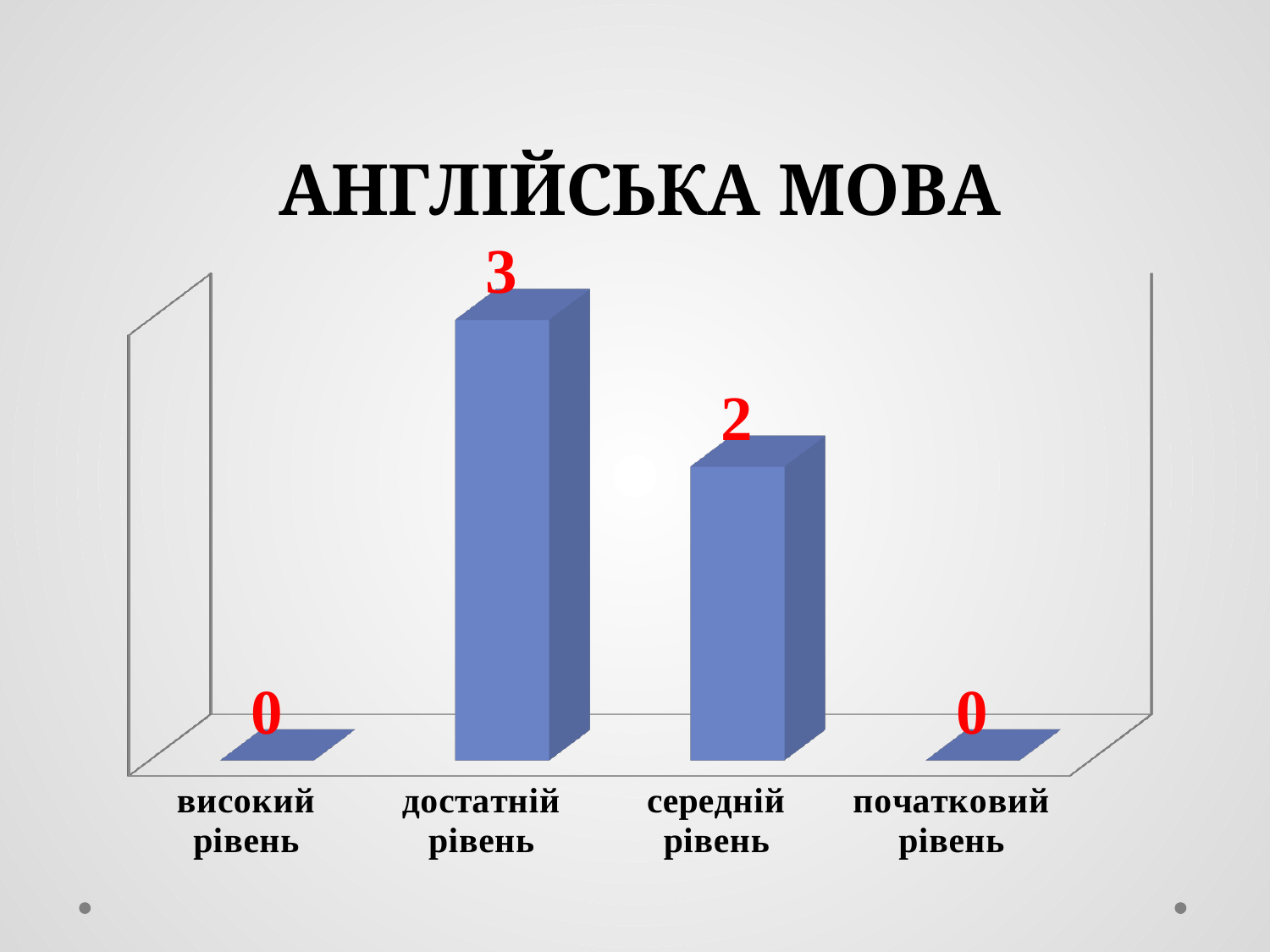
What is the difference between the values for достатній рівень and середній рівень? 1 Which category has the highest value? достатній рівень What kind of chart is shown on the slide? bar chart What is the total of all the values shown in the chart? 5 Which is larger, the value for достатній рівень or the value for середній рівень? достатній рівень What is the title of the chart? АНГЛІЙСЬКА МОВА How many categories have a value of 0? 2 What is the value for достатній рівень? 3 What is the value for середній рівень? 2 What is the value for високий рівень? 0 How many categories are shown on the x axis? 4 What is the value for початковий рівень? 0